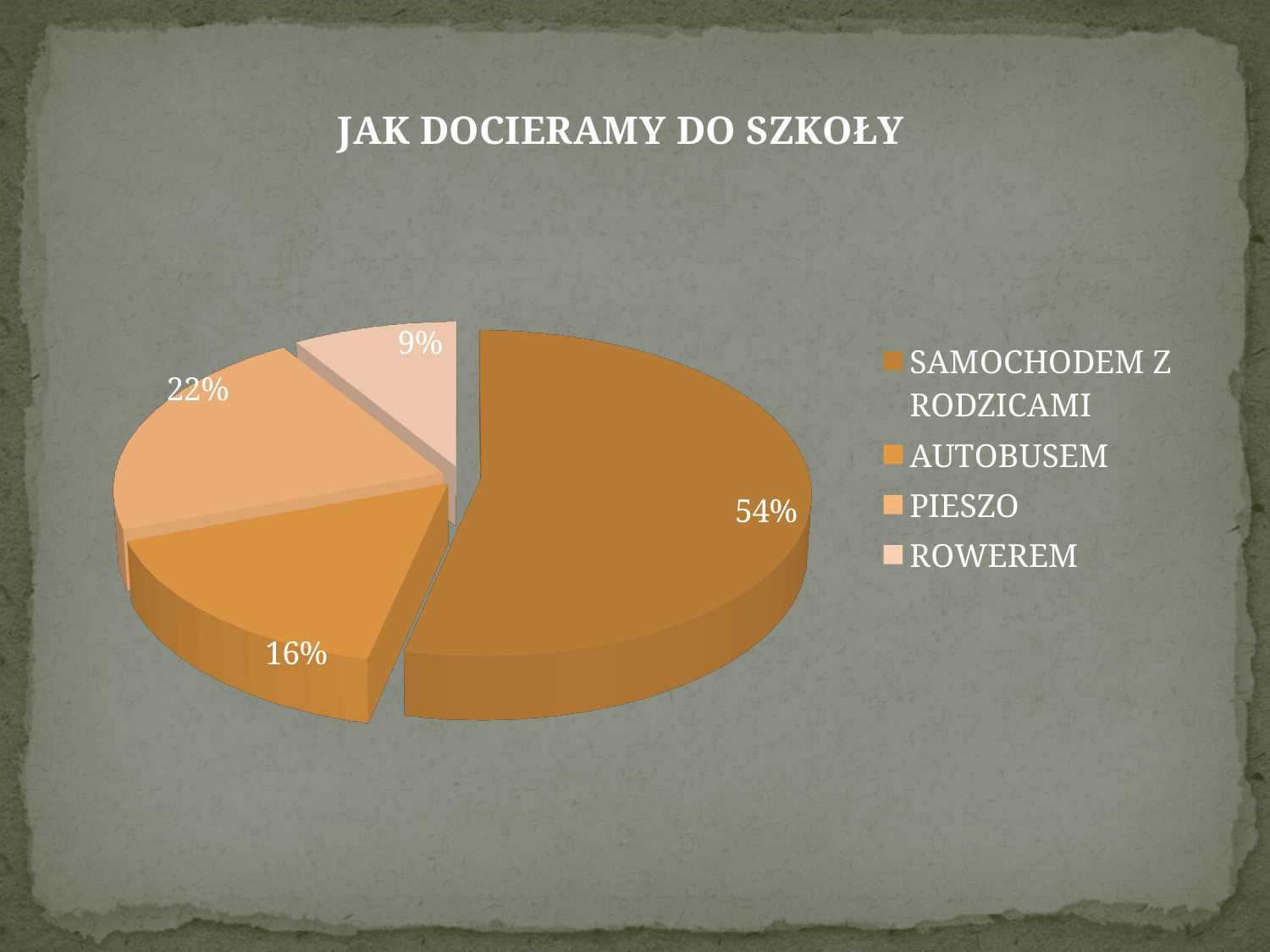
What kind of chart is shown on the slide? Pie chart Which is larger, PIESZO or AUTOBUSEM? PIESZO How many entries does the legend list? 4 How many categories does the pie chart have? 4 Which category has the smallest slice? ROWEREM Which category has the largest slice? SAMOCHODEM Z RODZICAMI What share of the pie is PIESZO? 22% What share of the pie is SAMOCHODEM Z RODZICAMI? 54% What share of the pie is AUTOBUSEM? 16% What is the difference in percentage points between SAMOCHODEM Z RODZICAMI and PIESZO? 32 What is the title of the chart? JAK DOCIERAMY DO SZKOŁY